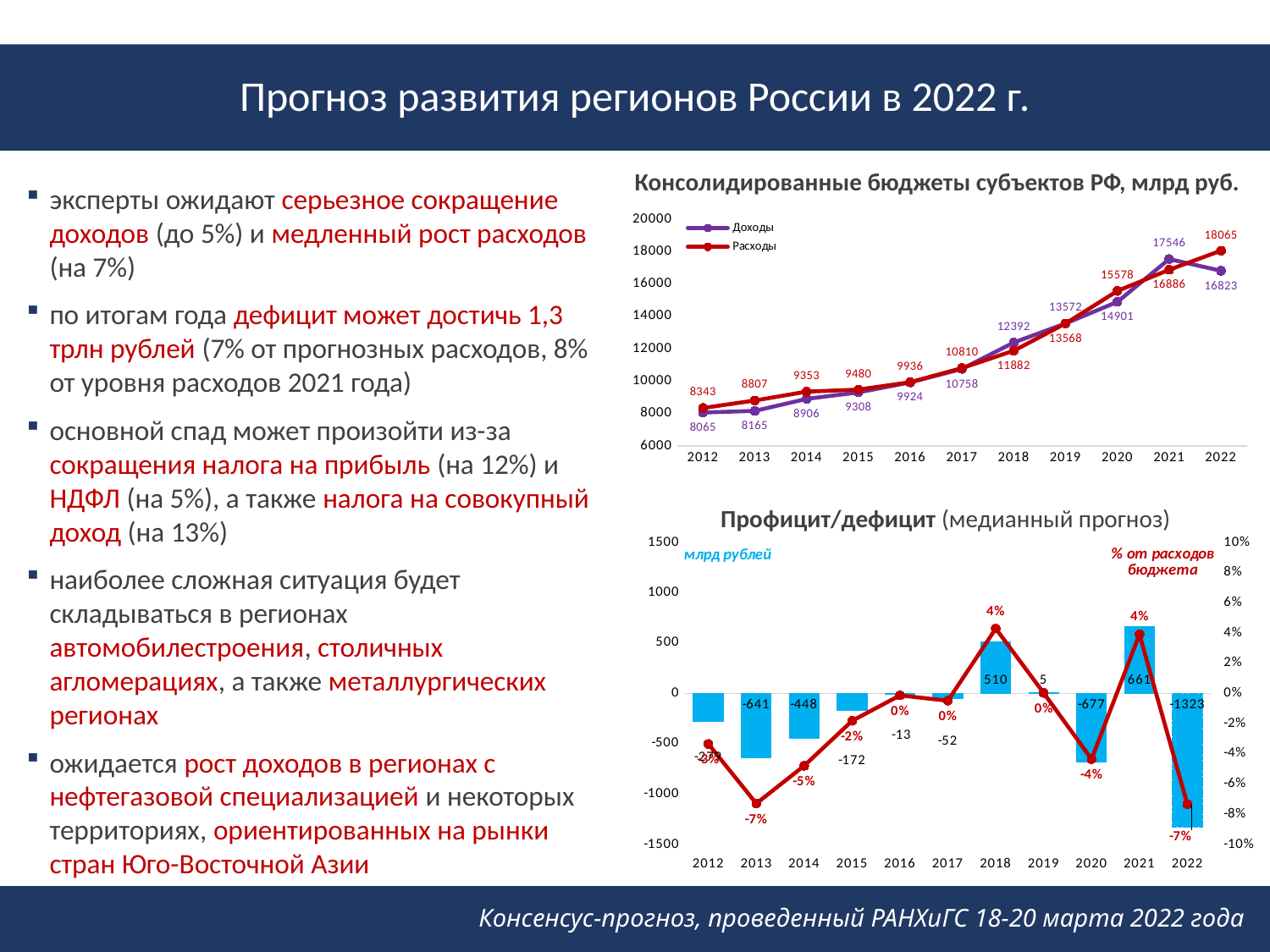
What kind of chart is 'Консолидированные бюджеты субъектов РФ, млрд руб.'? line chart In the chart 'Консолидированные бюджеты субъектов РФ, млрд руб.', which is larger in 2021, Доходы or Расходы? Доходы In the chart 'Профицит/дефицит (медианный прогноз)', which year has the highest bar value? 2021 In the chart 'Консолидированные бюджеты субъектов РФ, млрд руб.', what is the value of Доходы in 2022? 16823 In the chart 'Консолидированные бюджеты субъектов РФ, млрд руб.', in which year is Доходы highest? 2021 In the chart 'Профицит/дефицит (медианный прогноз)', which year has the lowest bar value? 2022 In the chart 'Консолидированные бюджеты субъектов РФ, млрд руб.', what is the difference between Расходы and Доходы in 2022? 1242 How many series does the legend of the chart 'Консолидированные бюджеты субъектов РФ, млрд руб.' list? 2 In the chart 'Профицит/дефицит (медианный прогноз)', what is the value in млрд рублей for 2022? -1323 In the chart 'Консолидированные бюджеты субъектов РФ, млрд руб.', what is the value of Доходы in 2012? 8065 In the chart 'Профицит/дефицит (медианный прогноз)', what is the percentage of budget expenditures shown for 2018? 4% In the chart 'Консолидированные бюджеты субъектов РФ, млрд руб.', what is the value of Расходы in 2022? 18065